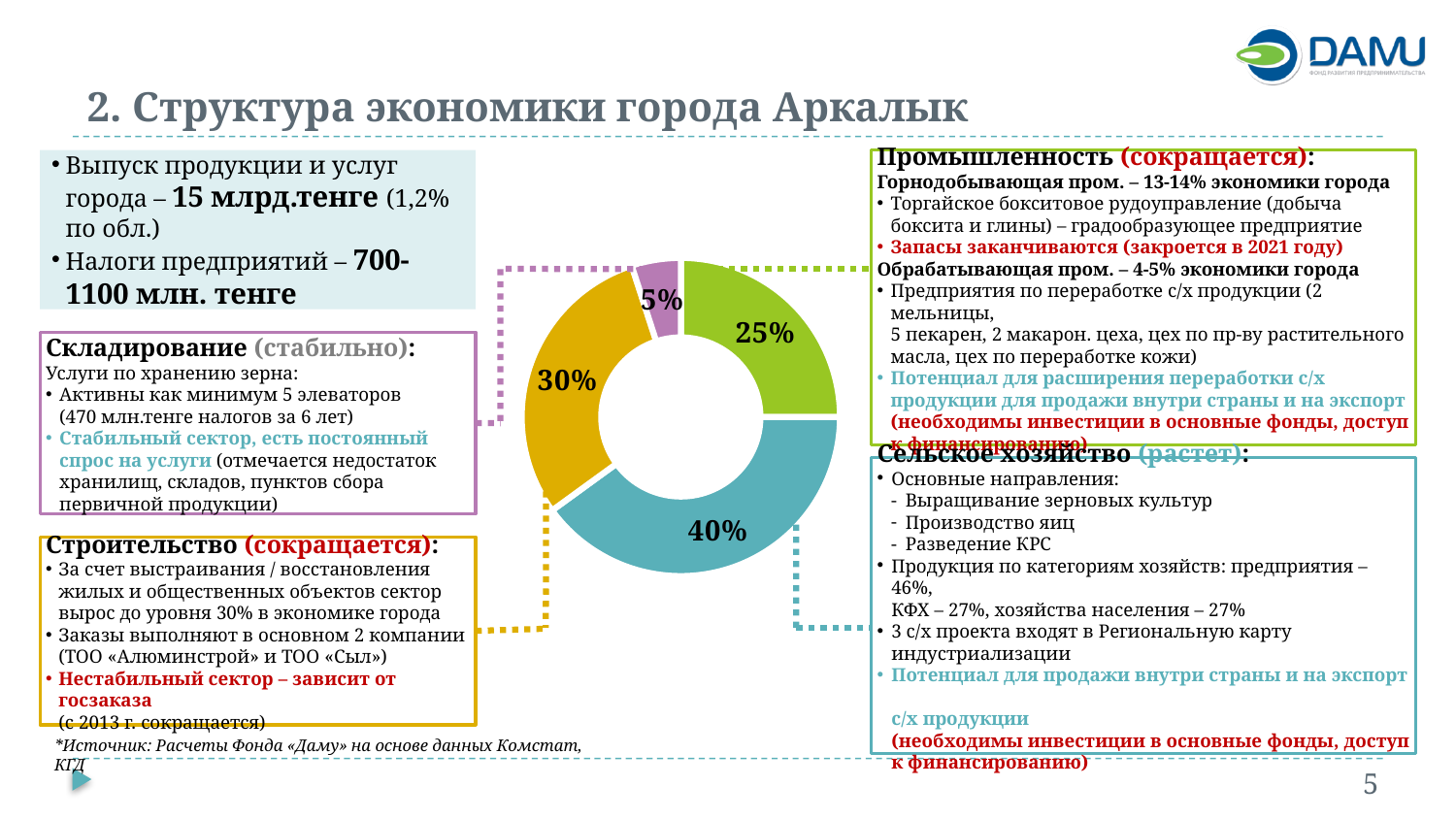
What kind of chart is shown in the centre of the slide? pie chart (donut) What value is shown on the slice connected by a dotted line to the 'Строительство' box? 30% What colour is the largest slice of the donut chart? teal (blue) What is the largest value shown on the donut chart? 40% What value is labelled on the teal (blue) slice of the donut chart? 40% What value is labelled on the green slice of the donut chart? 25% What is the smallest value shown on the donut chart? 5% How many slices does the donut chart have? 4 Which slice is larger on the donut chart, the green one or the yellow one? the yellow one (30%) What value is labelled on the yellow slice of the donut chart? 30% What is the difference between the largest slice (40%) and the yellow slice (30%) on the donut chart? 10 percentage points What value is labelled on the purple slice of the donut chart? 5%